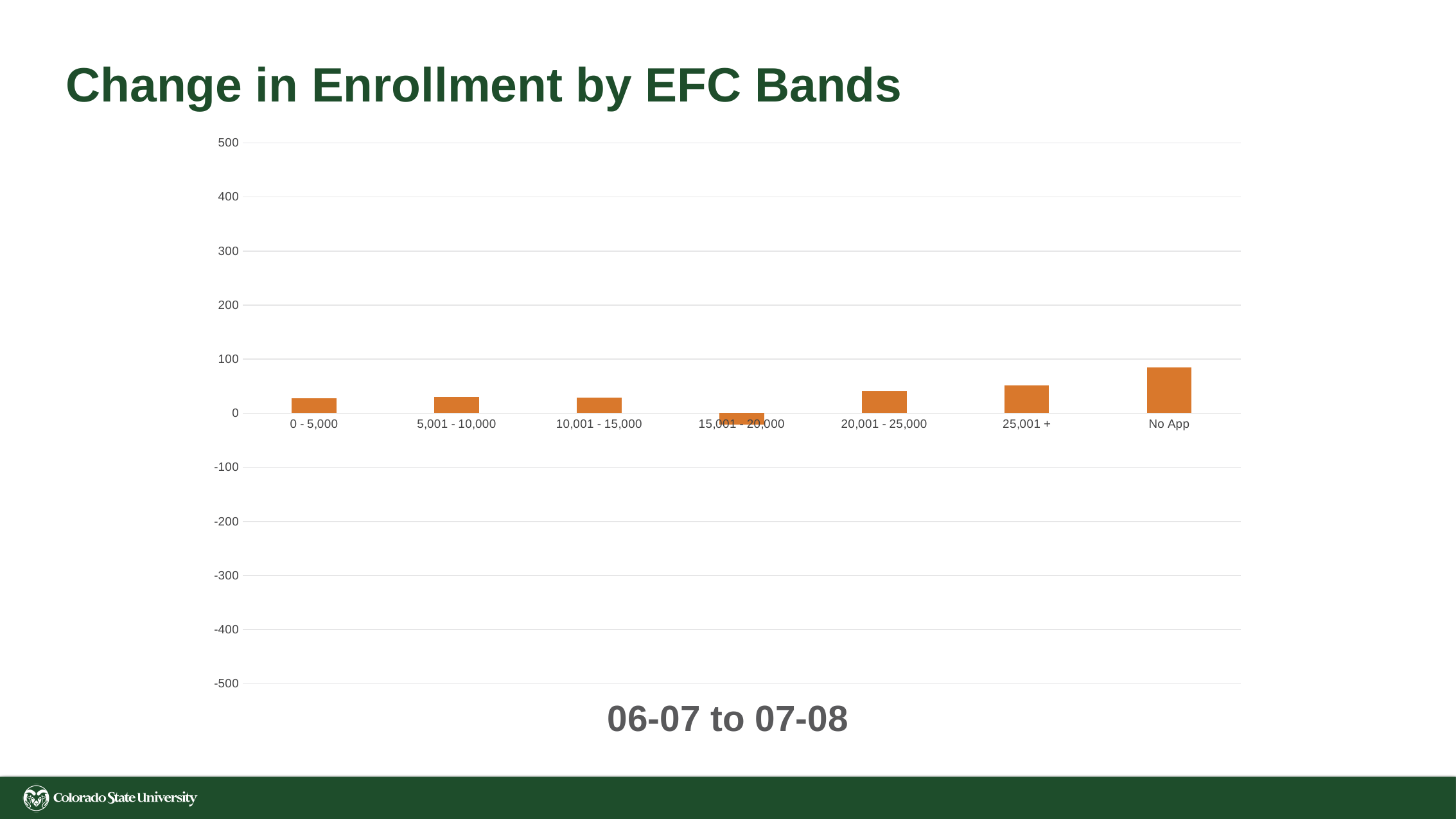
Is the value for 15,001 - 20,000 greater or less than 0? less Which is larger, the value for No App or the value for 0 - 5,000? No App Which category has the lowest change in enrollment? 15,001 - 20,000 What period label appears below the chart's x axis? 06-07 to 07-08 Is the value for No App greater or less than 100? less Which is larger, the value for 20,001 - 25,000 or the value for 15,001 - 20,000? 20,001 - 25,000 Is the value for 25,001 + greater or less than 100? less What is the title of the chart? Change in Enrollment by EFC Bands What kind of chart is shown on the slide? bar chart How many EFC band categories are plotted on the chart? 7 Which category has the highest change in enrollment? No App Which is larger, the value for 25,001 + or the value for 0 - 5,000? 25,001 +